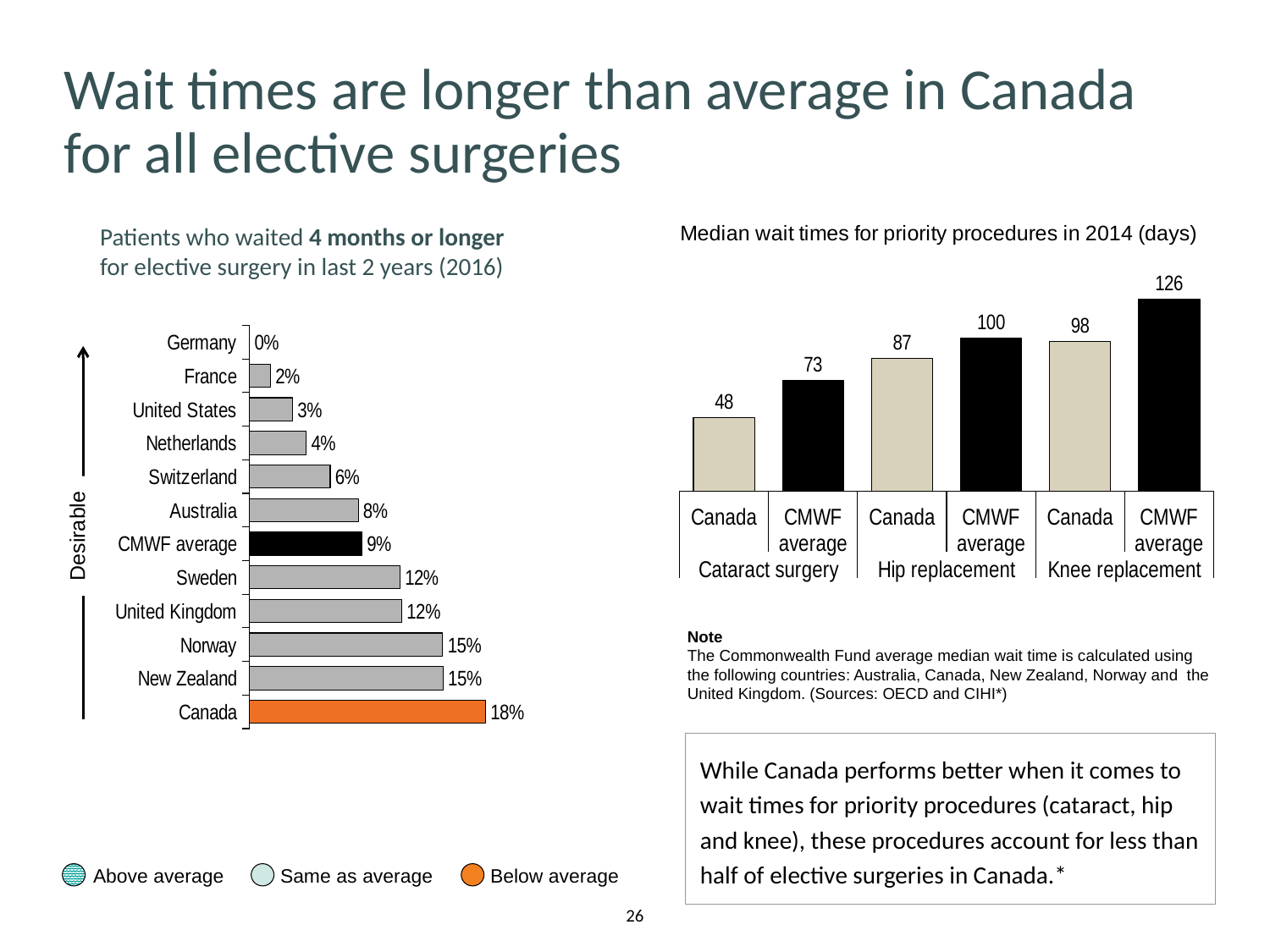
In the right chart (median wait times for priority procedures in 2014), which bar is the highest? CMWF average, knee replacement In the right chart (median wait times for priority procedures in 2014), what is the CMWF average for knee replacement? 126 In the left chart (patients who waited 4 months or longer for elective surgery), which country has the highest value? Canada In the left chart (patients who waited 4 months or longer for elective surgery), which is larger, the value for Switzerland or the value for Australia? Australia In the left chart (patients who waited 4 months or longer for elective surgery), which country has the lowest value? Germany In the right chart (median wait times for priority procedures in 2014), what is the difference between the CMWF average and Canada for hip replacement? 13 What type of chart is the right chart (median wait times for priority procedures in 2014)? Bar chart In the left chart (patients who waited 4 months or longer for elective surgery), how many bars are plotted? 12 In the left chart (patients who waited 4 months or longer for elective surgery), what is the value for the CMWF average? 9% In the left chart (patients who waited 4 months or longer for elective surgery), what is the value for Canada? 18% In the left chart (patients who waited 4 months or longer for elective surgery), what is the difference between Canada and the CMWF average? 9% In the right chart (median wait times for priority procedures in 2014), what is the median wait time for Canada for cataract surgery? 48